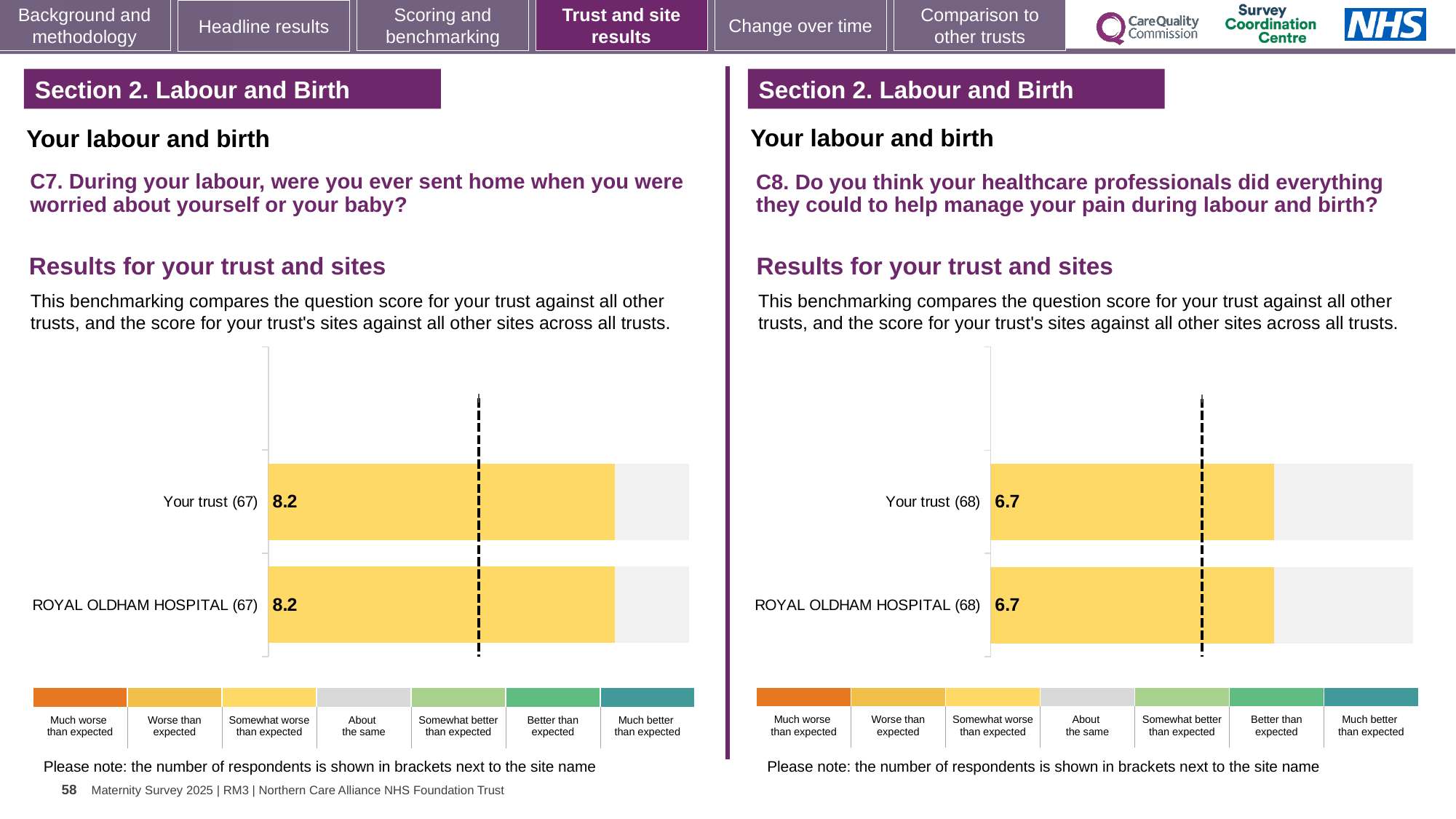
Is the Your trust score in the C7 chart on the left larger or smaller than the Your trust score in the C8 chart on the right? Larger In the C8 chart on the right, what is the score for Your trust? 6.7 In the C8 chart on the right, what is the score for ROYAL OLDHAM HOSPITAL? 6.7 In the C7 chart on the left, what is the score for ROYAL OLDHAM HOSPITAL? 8.2 How many bars are plotted in the C7 chart on the left? 2 In the C7 chart on the left, what is the difference between the score for Your trust and the score for ROYAL OLDHAM HOSPITAL? 0 In the C7 chart on the left, what is the score for Your trust? 8.2 How many bars are plotted in the C8 chart on the right? 2 In the C8 chart on the right, how many respondents are shown in brackets next to ROYAL OLDHAM HOSPITAL? 68 What kind of chart is used in the C7 chart on the left? Bar chart In the C7 chart on the left, how many respondents are shown in brackets next to Your trust? 67 In the C8 chart on the right, what is the difference between the score for Your trust and the score for ROYAL OLDHAM HOSPITAL? 0